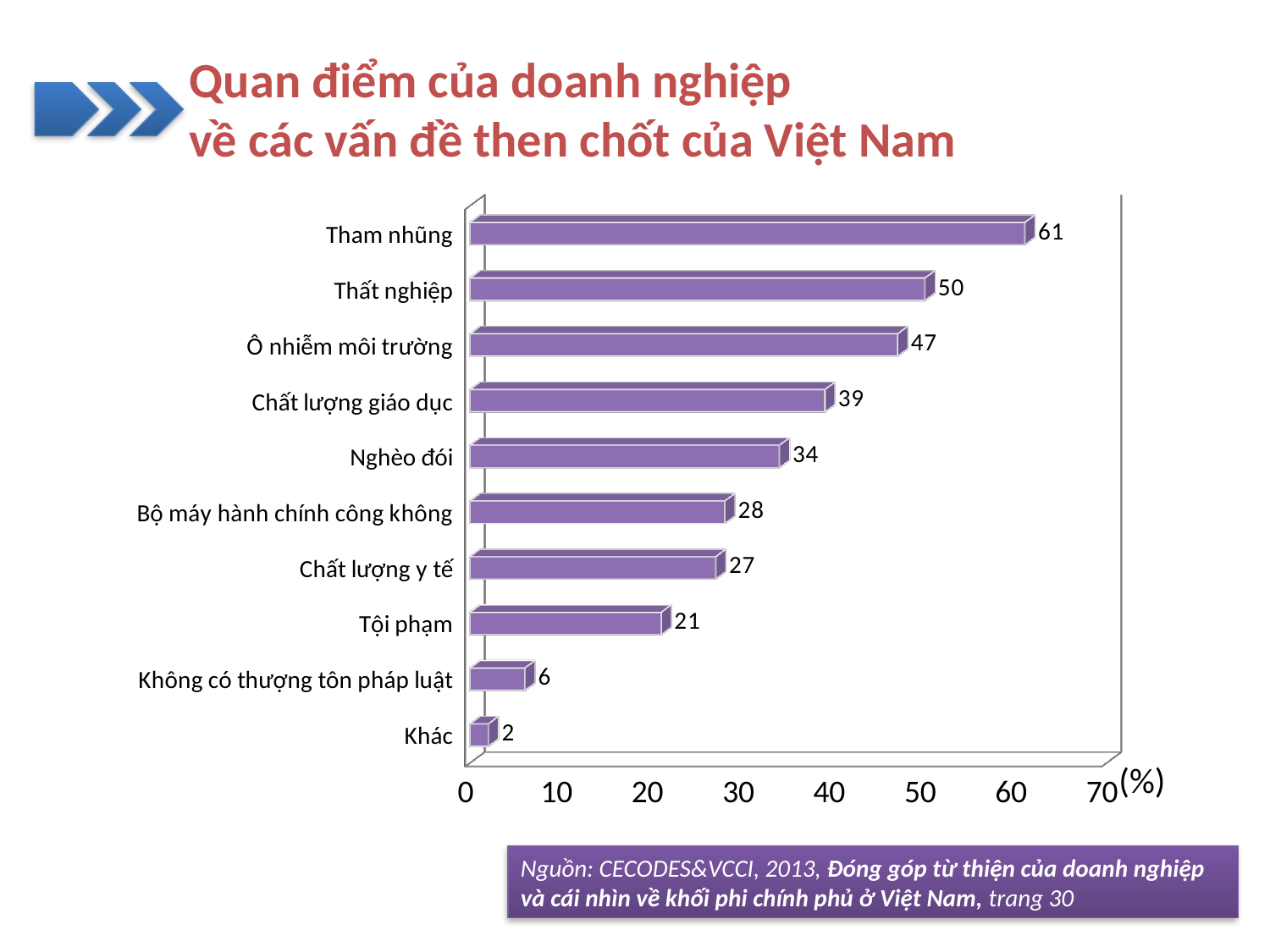
What kind of chart is shown on the slide? bar chart What unit is shown at the end of the horizontal axis? (%) Which category has the highest value? Tham nhũng How many categories are shown in the chart? 10 Is the value for Bộ máy hành chính công không greater or less than 30? less What is the difference between the values for Thất nghiệp and Ô nhiễm môi trường? 3 What is the difference between the values for Tham nhũng and Tội phạm? 40 Which is larger, the value for Nghèo đói or the value for Chất lượng y tế? Nghèo đói What is the value for Chất lượng giáo dục? 39 Which category has the lowest value? Khác What is the value for Tham nhũng? 61 What is the value for Không có thượng tôn pháp luật? 6